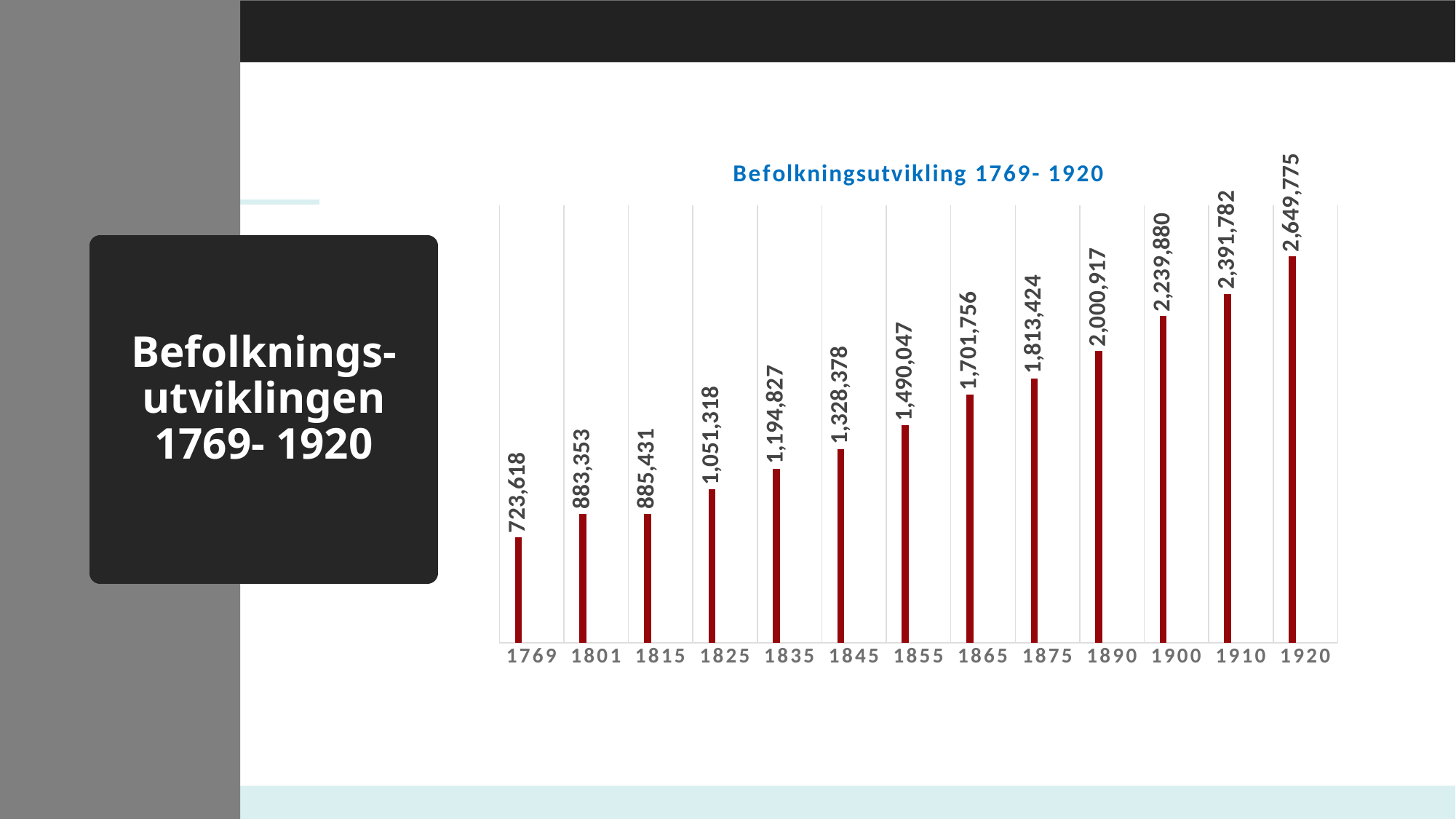
Which is larger, the value for 1855 or the value for 1845? 1855 Do the values rise or fall from 1769 to 1920? Rise What kind of chart is shown on the slide? Bar chart What is the value shown for 1769? 723,618 What is the title of the chart? Befolkningsutvikling 1769- 1920 Which year has the lowest value in the chart? 1769 What is the difference between the values for 1920 and 1769? 1,926,157 What is the value shown for 1890? 2,000,917 Which year has the highest value in the chart? 1920 What is the population value shown for 1835? 1,194,827 How many years are shown on the x axis of the chart? 13 What is the difference between the values for 1900 and 1890? 238,963